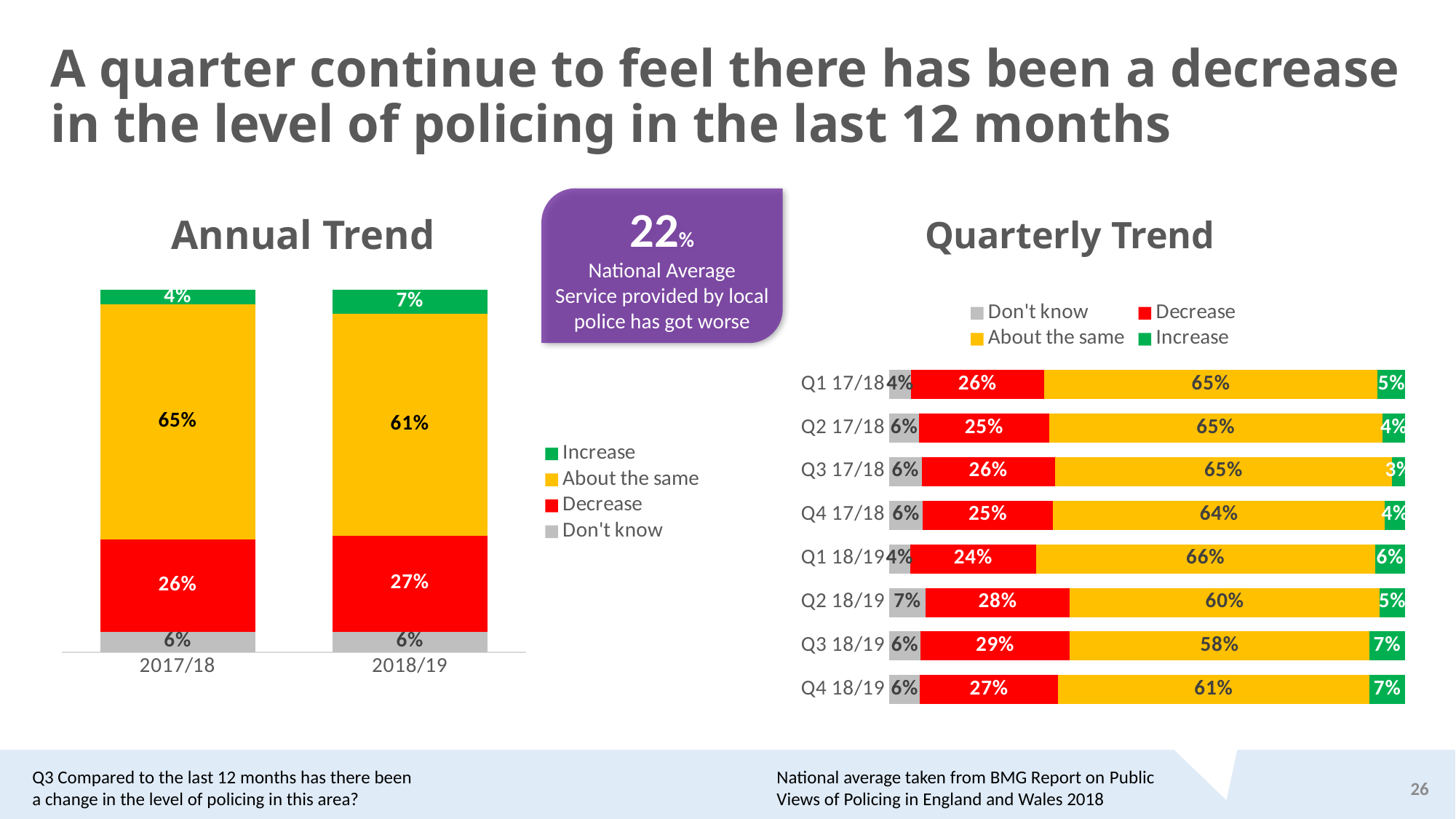
In the Annual Trend chart, how many series does the legend list? 4 In the Quarterly Trend chart, what percentage said 'Don't know' in Q2 18/19? 7% In the Quarterly Trend chart, is the 'About the same' value larger in Q1 18/19 or Q3 18/19? Q1 18/19 In the Annual Trend chart, what is the difference between the 'Decrease' values for 2018/19 and 2017/18? 1% In the Quarterly Trend chart, which quarter has the highest 'Decrease' value? Q3 18/19 In the Annual Trend chart, what percentage said 'Increase' in 2017/18? 4% In the Quarterly Trend chart, how many quarters are shown? 8 In the Quarterly Trend chart, what is the difference between the 'About the same' values for Q1 18/19 and Q3 18/19? 8% In the Quarterly Trend chart, which quarter has the lowest 'Increase' value? Q3 17/18 What kind of chart is the Quarterly Trend chart? Stacked bar chart In the Quarterly Trend chart, what percentage said 'Decrease' in Q3 18/19? 29% In the Annual Trend chart, what percentage said 'About the same' in 2018/19? 61%